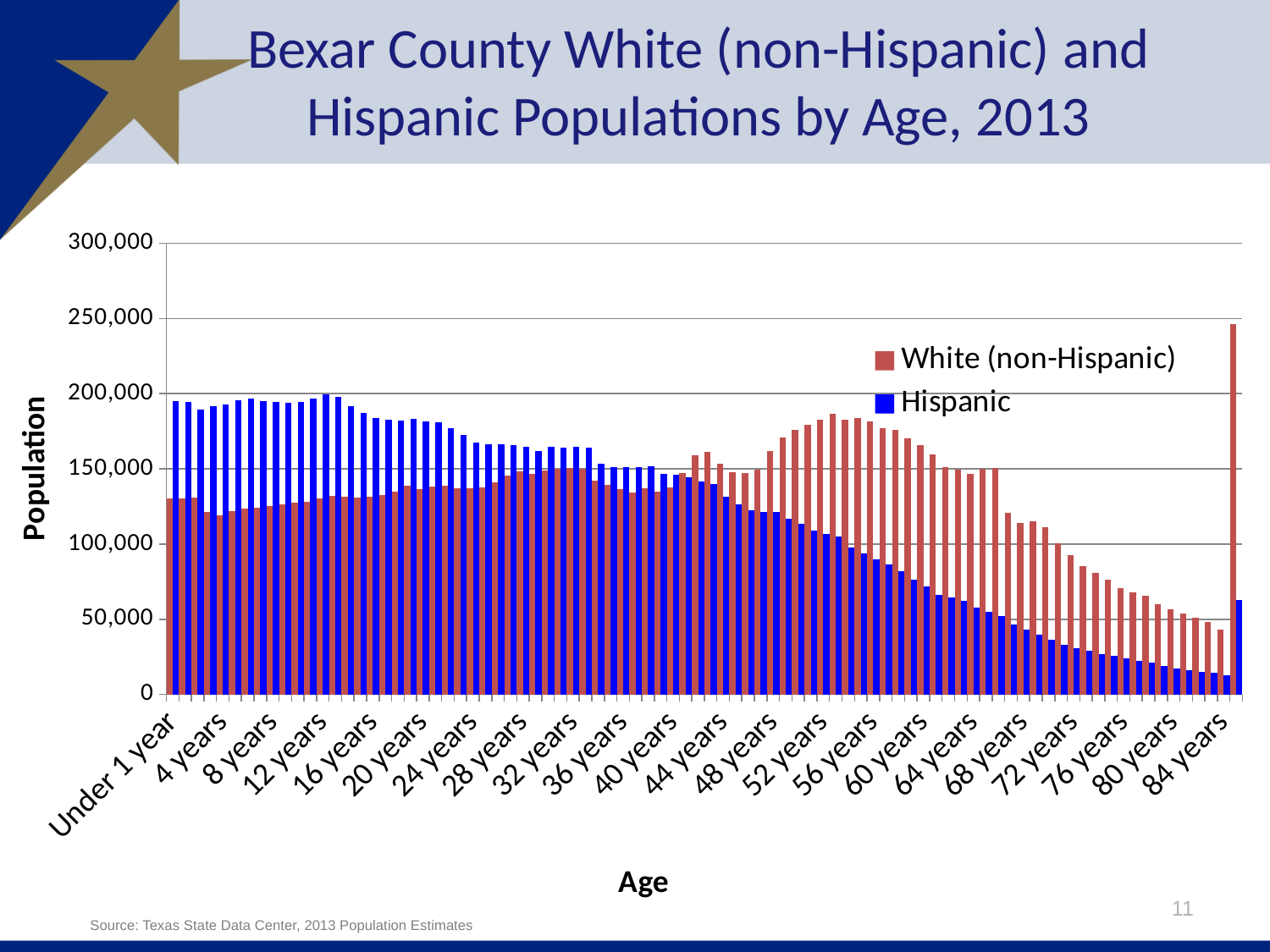
Which series is shown in blue? Hispanic How many series does the legend list? 2 Is the Hispanic value for Under 1 year greater or less than 150,000? greater What kind of chart is shown on the slide? Bar chart What is the label on the vertical axis? Population Is the Hispanic value for 84 years greater or less than 50,000? less At Under 1 year, which series has the larger value, White (non-Hispanic) or Hispanic? Hispanic Do the Hispanic values generally rise or fall from 16 years to 84 years? fall At 56 years, which series has the larger value, White (non-Hispanic) or Hispanic? White (non-Hispanic) Is the White (non-Hispanic) value for 56 years greater or less than 150,000? greater